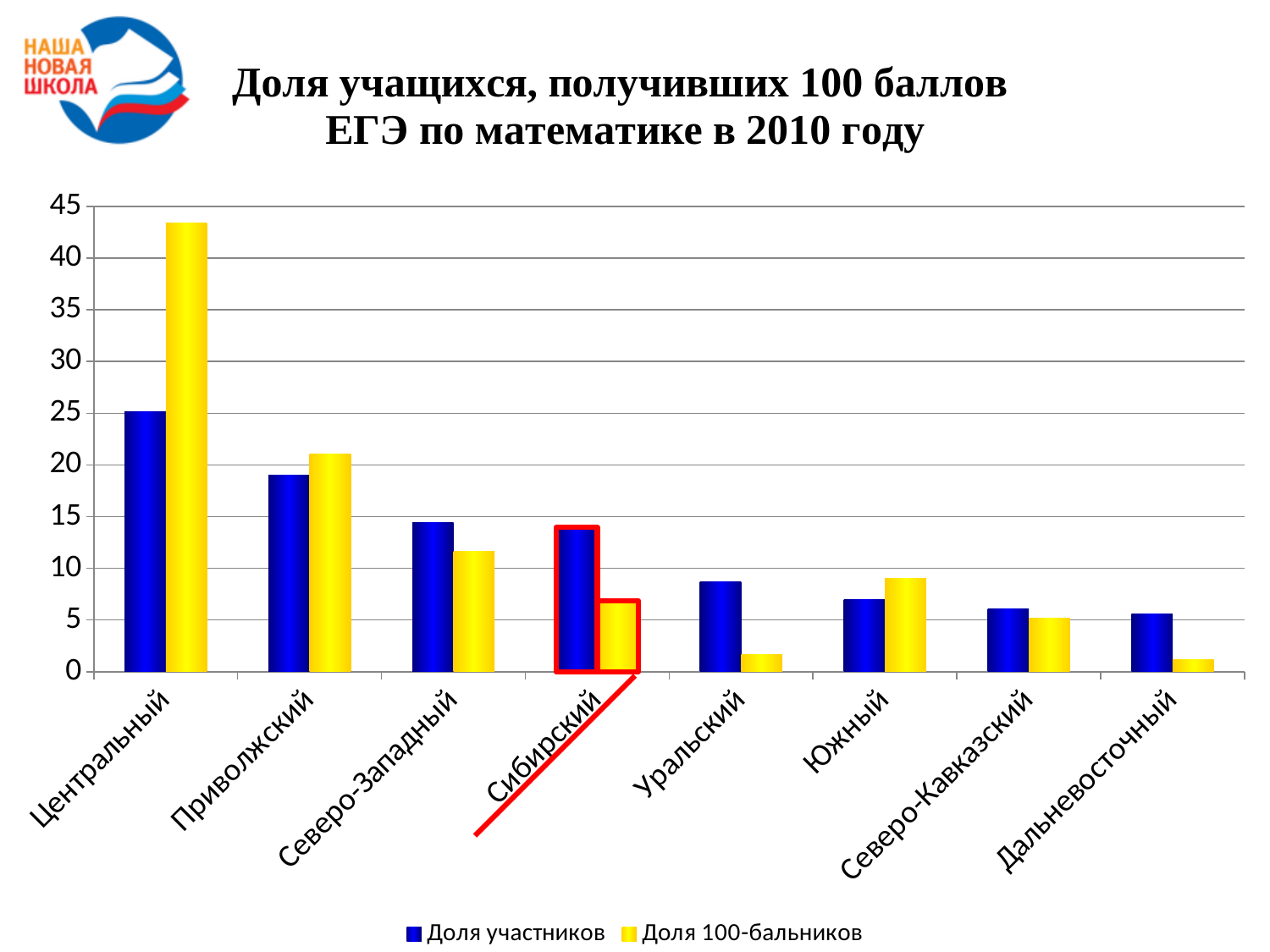
Is the value of Доля 100-бальников for Сибирский greater or less than 10? less How many series does the legend list? 2 What kind of chart is shown on the slide? Bar chart For Сибирский, which is larger: Доля участников or Доля 100-бальников? Доля участников Is the value of Доля участников for Центральный greater or less than 20? greater Do the Доля участников values rise or fall from left to right along the x axis? fall For Центральный, which is larger: Доля участников or Доля 100-бальников? Доля 100-бальников Is the value of Доля 100-бальников for Уральский greater or less than 5? less Which region has the highest value for Доля 100-бальников? Центральный How many regions (categories) are shown on the x axis? 8 Which region has the highest value for Доля участников? Центральный